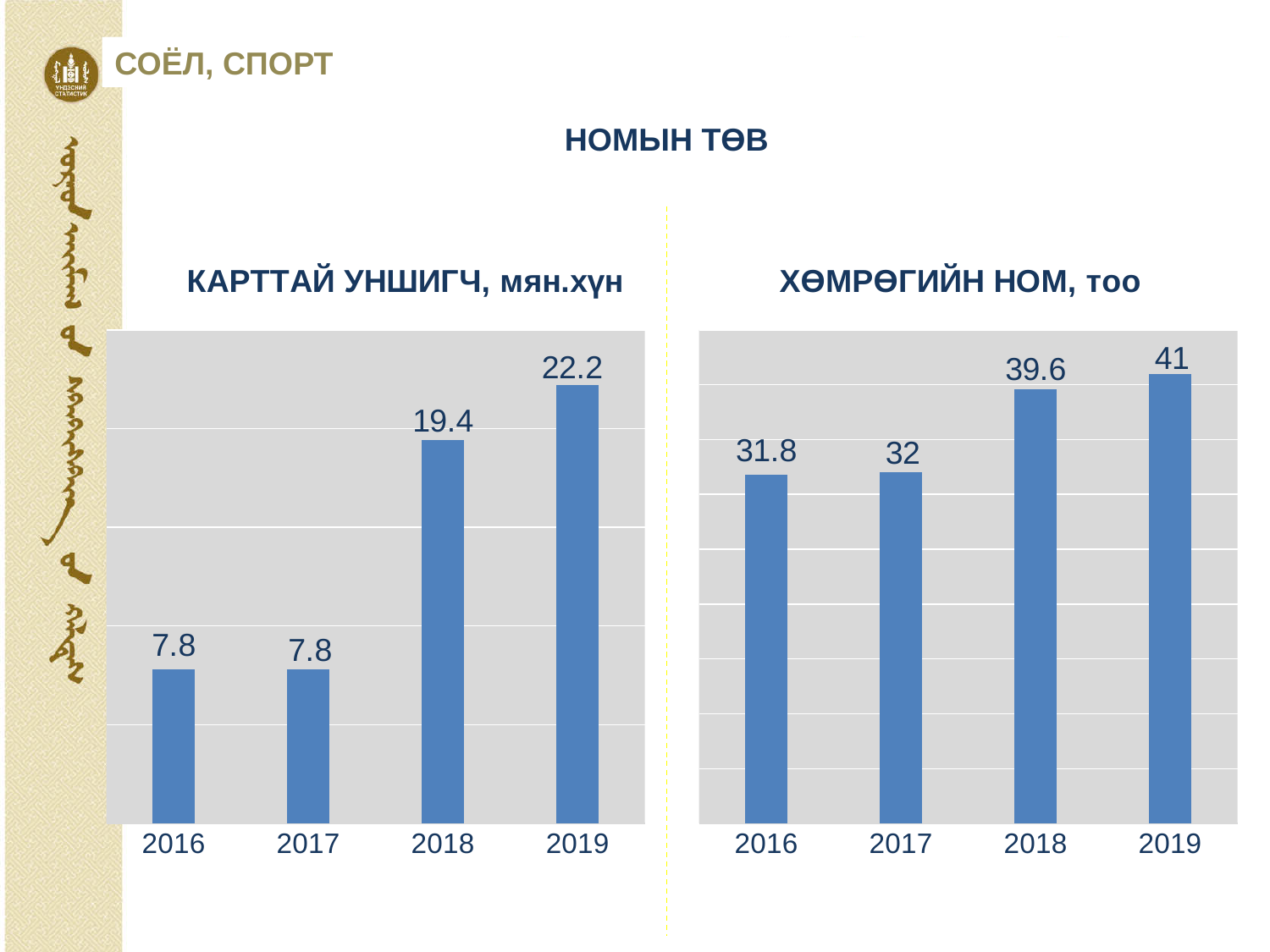
In the 'КАРТТАЙ УНШИГЧ, мян.хүн' chart, which year has the highest value? 2019 In the 'КАРТТАЙ УНШИГЧ, мян.хүн' chart, what is the value for 2018? 19.4 In the 'ХӨМРӨГИЙН НОМ, тоо' chart, what is the value for 2017? 32 In the 'ХӨМРӨГИЙН НОМ, тоо' chart, what is the difference between the 2019 and 2016 values? 9.2 In the 'ХӨМРӨГИЙН НОМ, тоо' chart, which is larger, the value for 2018 or the value for 2017? 2018 What kind of chart is the 'КАРТТАЙ УНШИГЧ, мян.хүн' chart? bar chart In the 'ХӨМРӨГИЙН НОМ, тоо' chart, which year has the lowest value? 2016 In the 'КАРТТАЙ УНШИГЧ, мян.хүн' chart, what is the difference between the 2019 and 2018 values? 2.8 In the 'КАРТТАЙ УНШИГЧ, мян.хүн' chart, what is the value for 2016? 7.8 In the 'КАРТТАЙ УНШИГЧ, мян.хүн' chart, how many years are shown on the x axis? 4 In the 'ХӨМРӨГИЙН НОМ, тоо' chart, what is the value for 2019? 41 In the 'ХӨМРӨГИЙН НОМ, тоо' chart, do the values rise or fall from 2016 to 2019? rise